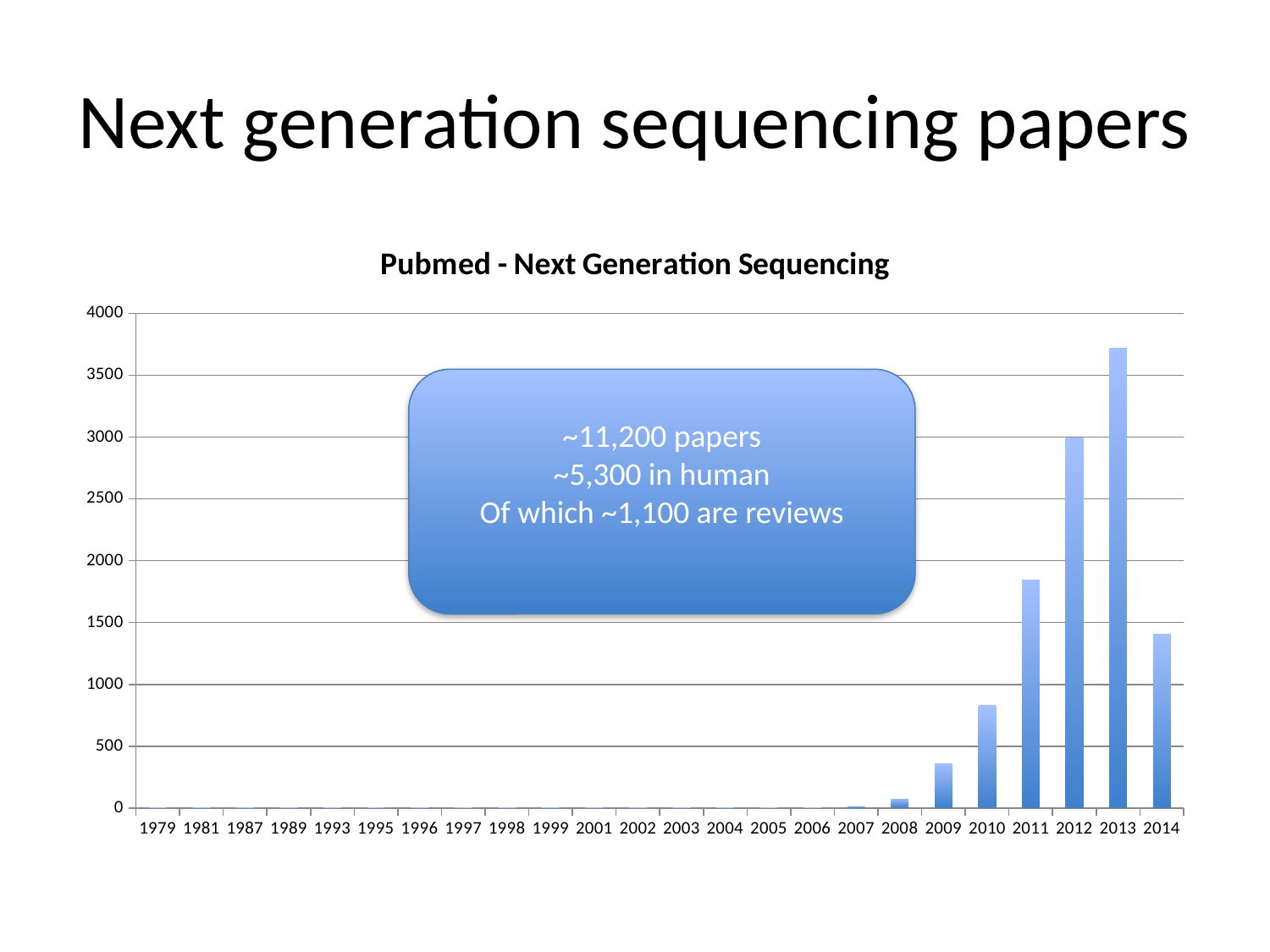
Is the value for 2011 greater or less than 2000? less Do the values rise or fall from 2008 to 2013? rise Which year has the larger value, 2011 or 2014? 2011 Which year has the highest number of papers? 2013 What kind of chart is shown on the slide? bar chart Is the value for 2009 greater or less than 500? less Is the value for 2013 greater or less than 3500? greater According to the callout box on the chart, approximately how many papers are in human? ~5,300 How many years are shown on the x axis? 24 What is the title of the chart? Pubmed - Next Generation Sequencing